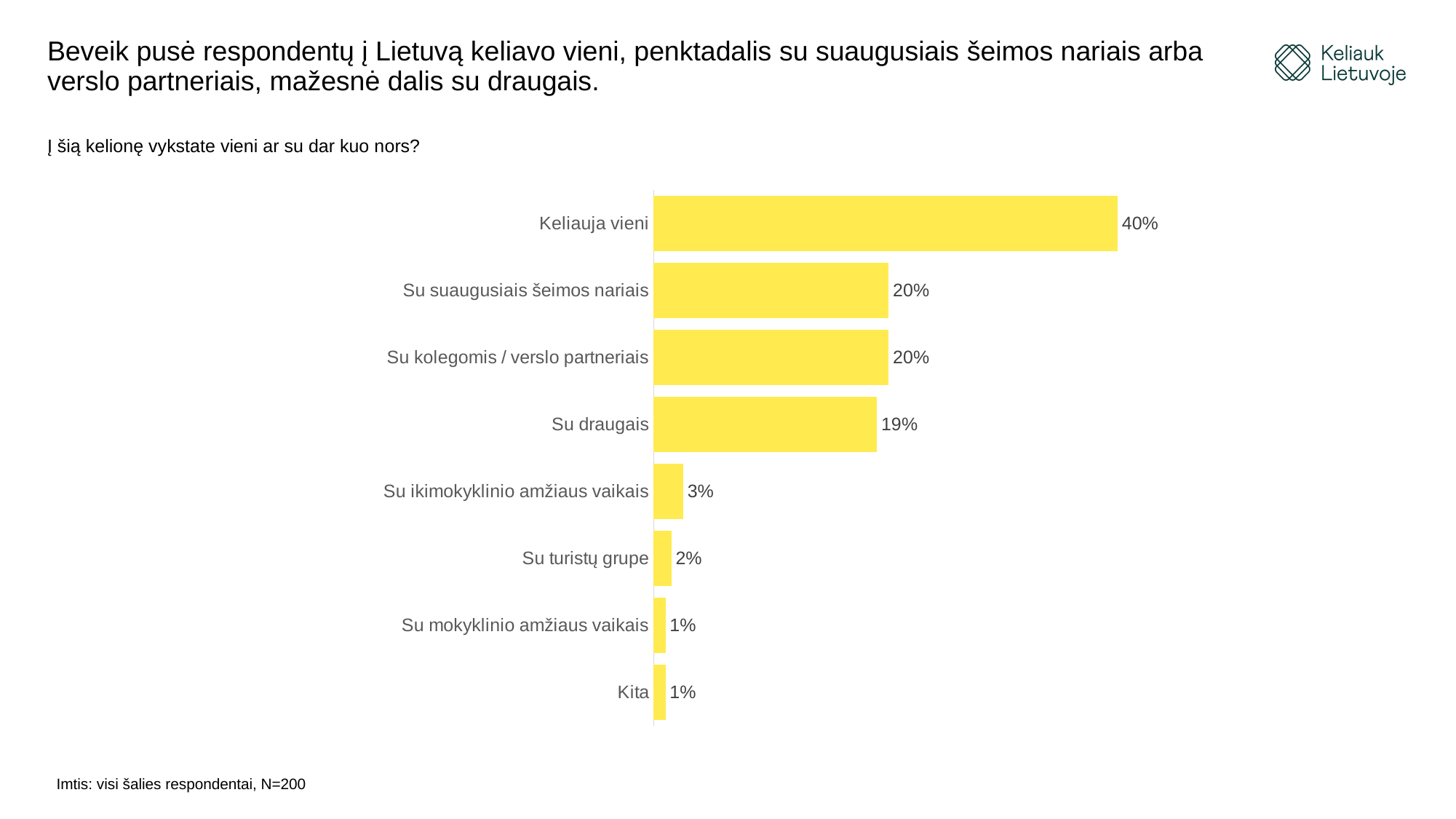
What is the difference between "Su draugais" and "Su ikimokyklinio amžiaus vaikais"? 16% What is the value for "Su turistų grupe"? 2% What is the difference between "Keliauja vieni" and "Su suaugusiais šeimos nariais"? 20% What is the value for "Su draugais"? 19% How many categories are shown in the chart? 8 What is the value for "Su kolegomis / verslo partneriais"? 20% What question is the chart based on, as shown above the chart? Į šią kelionę vykstate vieni ar su dar kuo nors? Which is larger: "Su draugais" or "Su turistų grupe"? Su draugais What is the value for "Su ikimokyklinio amžiaus vaikais"? 3% What kind of chart is shown on the slide? Bar chart Which category has the highest value? Keliauja vieni What is the value for "Keliauja vieni"? 40%